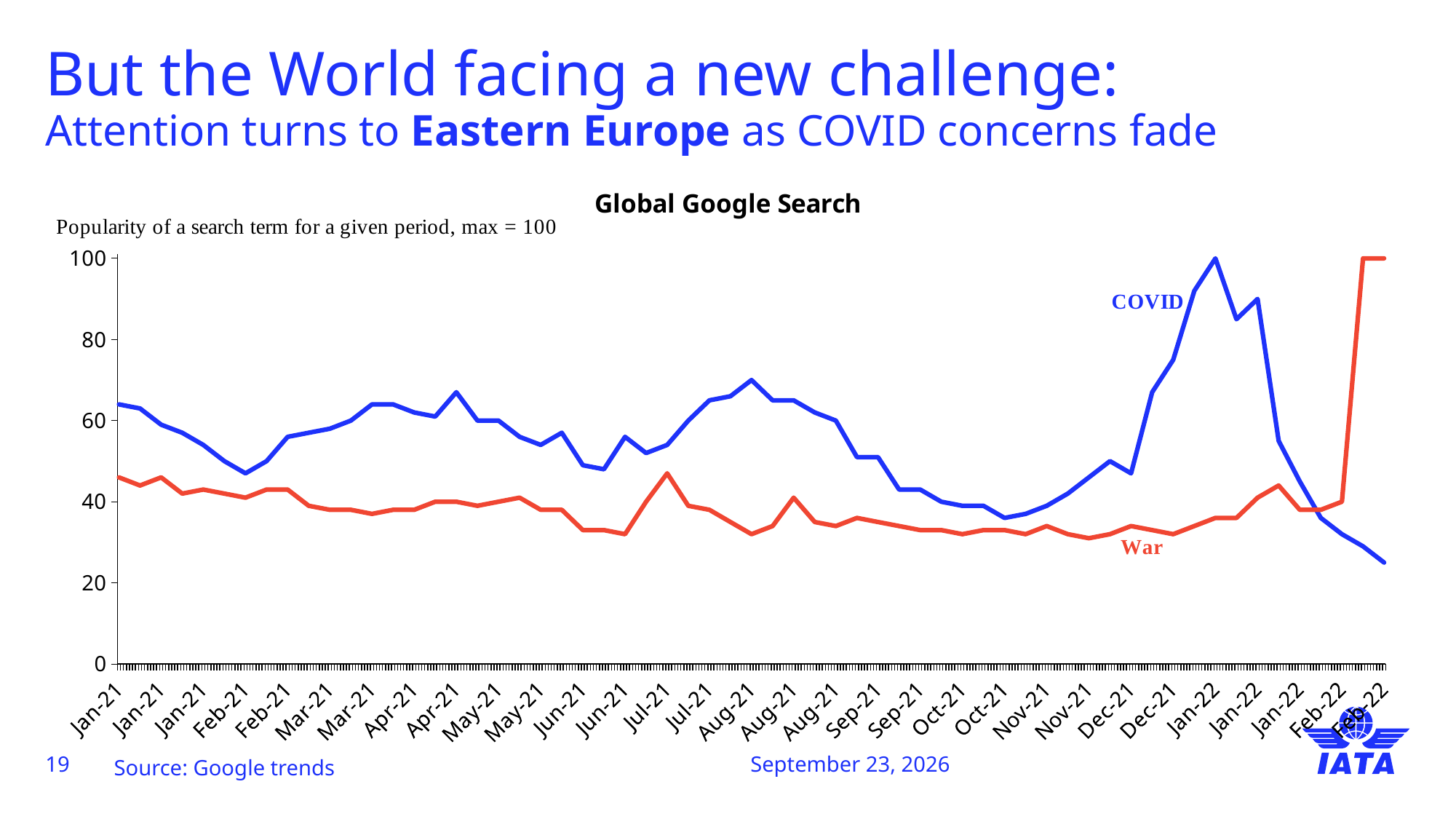
What is the peak value reached by the COVID series? 100 What kind of chart is shown on the slide? line chart Which colour is used for the War series? red Is the COVID value at the start of the period (Jan-21) greater or less than 60? greater Does the COVID line rise or fall from its Jan-22 peak to the end of the period? fall What is the title of the chart? Global Google Search How many series are plotted on the chart? 2 Is the COVID value at the end of the period (Feb-22) greater or less than 40? less At the start of the period (Jan-21), which series is higher, COVID or War? COVID What value does the War series reach at the end of the period (Feb-22)? 100 Is the War value at the start of the period (Jan-21) greater or less than 40? greater At the end of the period (Feb-22), which series is higher, COVID or War? War